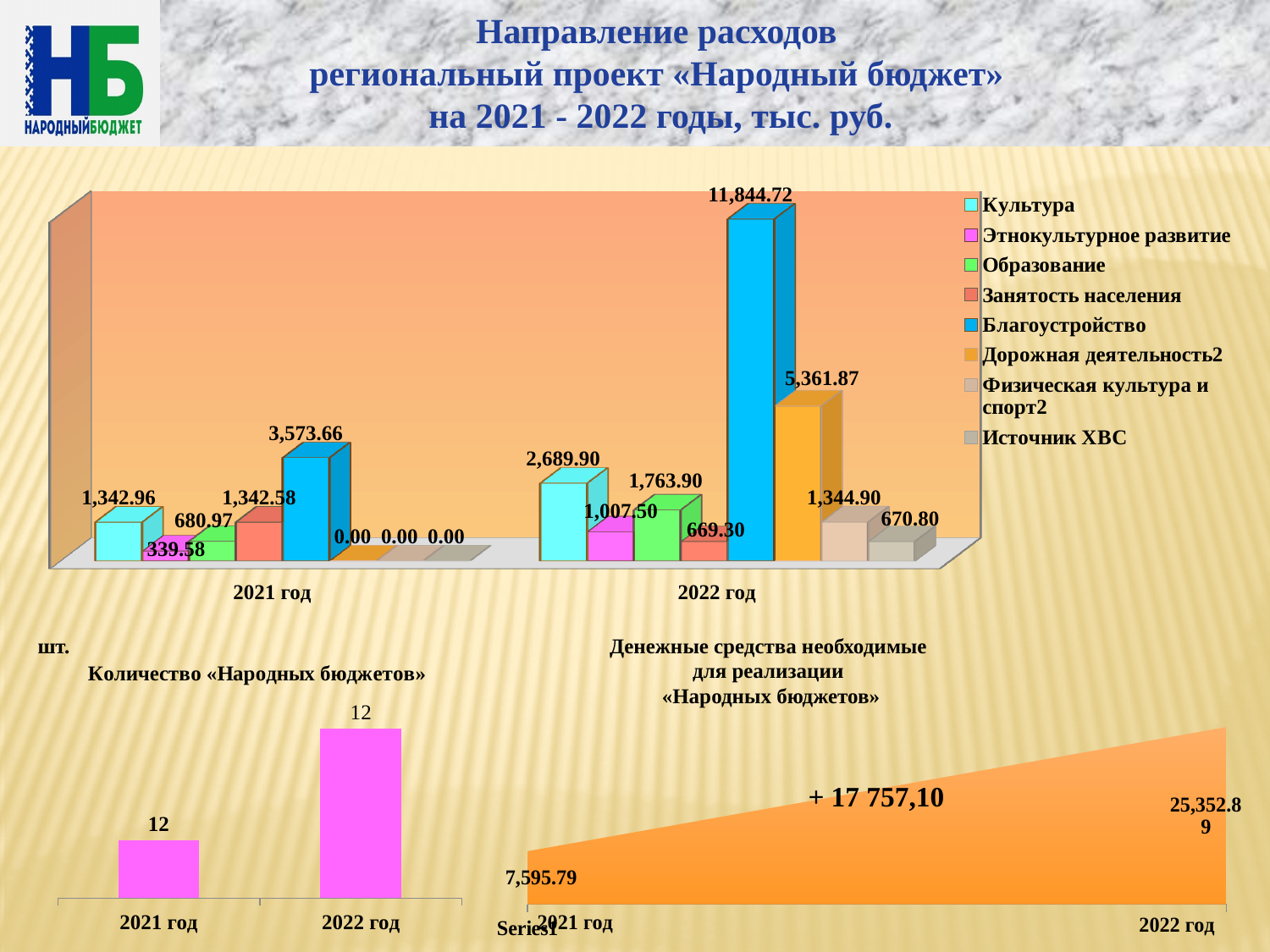
In the top chart 'Направление расходов', which series has the highest value in 2021 год? Благоустройство In the top chart 'Направление расходов', what is the value for Благоустройство in 2022 год? 11,844.72 In the top chart 'Направление расходов', how many series have a value of 0.00 in 2021 год? 3 In the top chart 'Направление расходов', what is the value for Культура in 2021 год? 1,342.96 In the bottom-right chart 'Денежные средства необходимые для реализации «Народных бюджетов»', what is the value for 2021 год? 7,595.79 What kind of chart is the bottom-left chart 'Количество «Народных бюджетов»'? bar chart In the top chart 'Направление расходов', what is the difference between the Благоустройство values for 2022 год and 2021 год? 8,271.06 In the top chart 'Направление расходов', what is the value for Дорожная деятельность2 in 2022 год? 5,361.87 In the top chart 'Направление расходов', which is larger: Образование in 2022 год or Занятость населения in 2022 год? Образование In the top chart 'Направление расходов', how many series does the legend list? 8 In the bottom-right chart 'Денежные средства необходимые для реализации «Народных бюджетов»', do the values rise or fall from 2021 год to 2022 год? rise